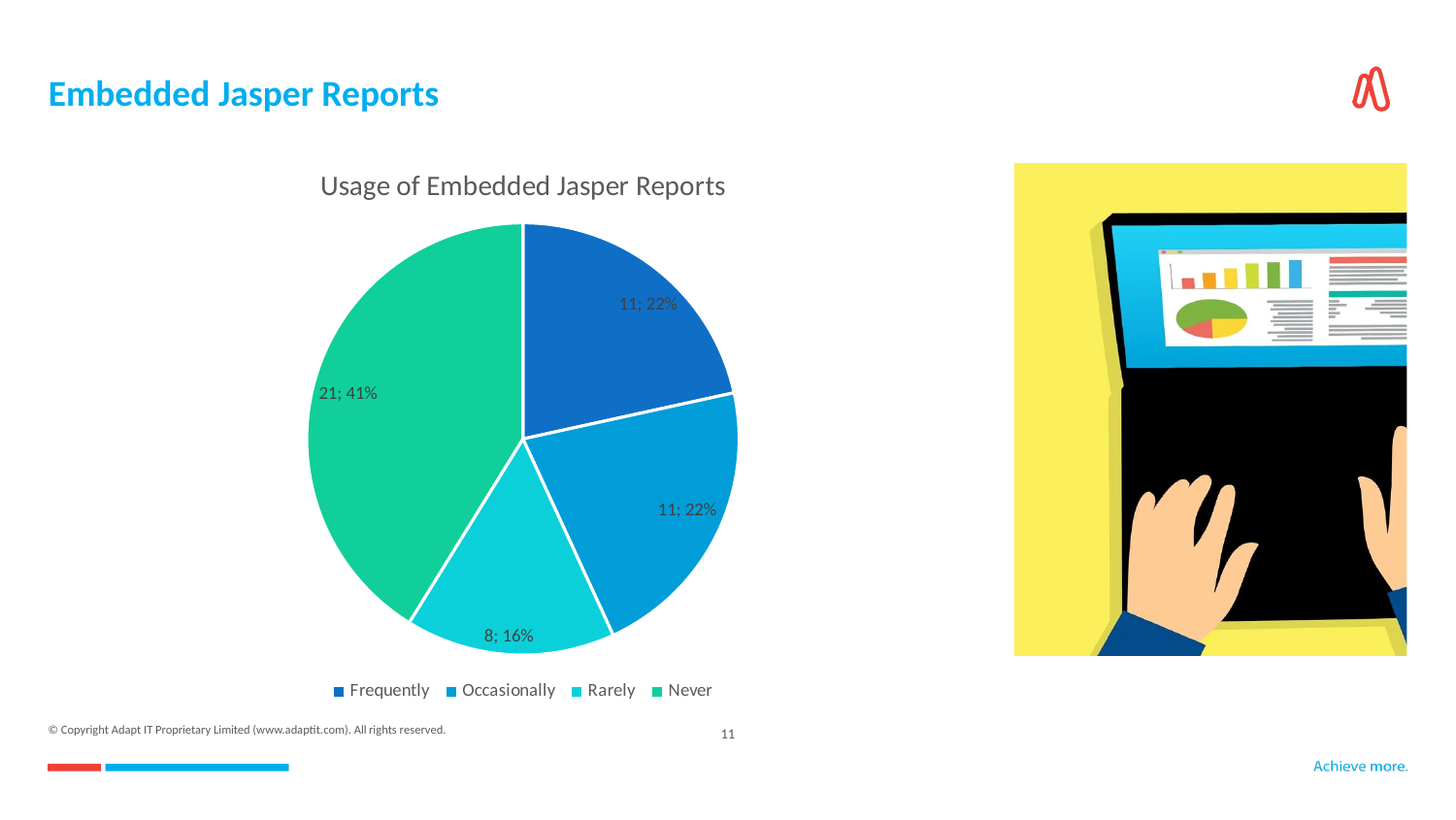
How many categories does the legend list? 4 Which category has the smallest slice of the pie? Rarely What percentage of the pie does the Frequently slice represent? 22% Which category has the largest slice of the pie? Never What count and percentage are shown for the Never slice? 21; 41% What count and percentage are shown for the Rarely slice? 8; 16% Which is larger, the Never slice or the Occasionally slice? Never What type of chart is shown on the slide? pie chart What is the title of the chart? Usage of Embedded Jasper Reports What count is shown for the Occasionally slice? 11 What is the difference in count between the Never slice and the Rarely slice? 13 Which legend entry is shown in green? Never